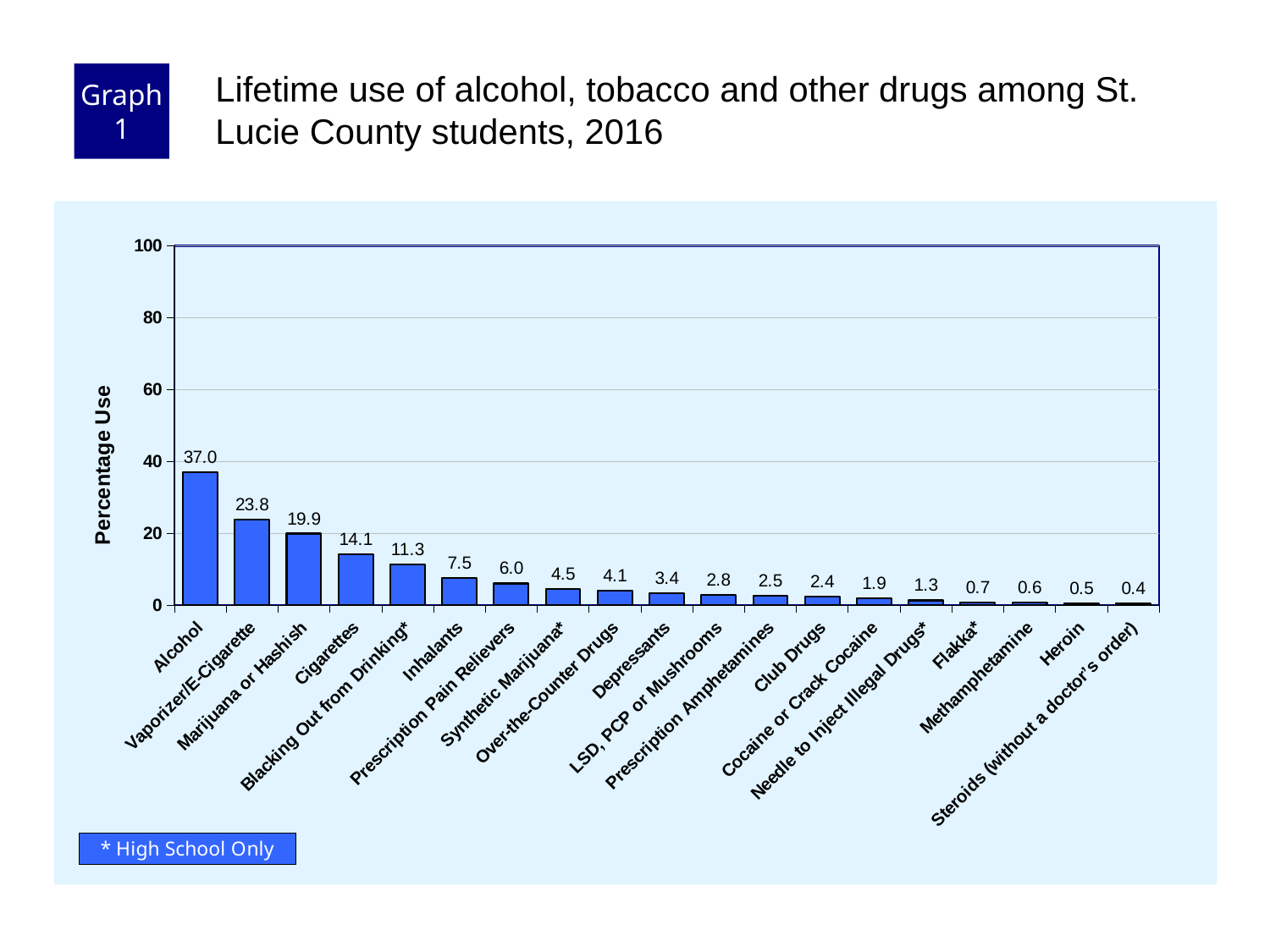
What is the label of the y axis? Percentage Use What is the percentage use for Heroin? 0.5 Which category has the lowest percentage use? Steroids (without a doctor's order) Which category has the highest percentage use? Alcohol What is the percentage use for Cigarettes? 14.1 How many categories are shown on the chart? 19 What is the percentage use for Alcohol? 37.0 Is the value for Vaporizer/E-Cigarette greater or less than 20? greater What is the percentage use for Inhalants? 7.5 What is the difference in percentage use between Alcohol and Vaporizer/E-Cigarette? 13.2 What kind of chart is shown on the slide? Bar chart Which has a higher percentage use, Marijuana or Hashish or Cigarettes? Marijuana or Hashish